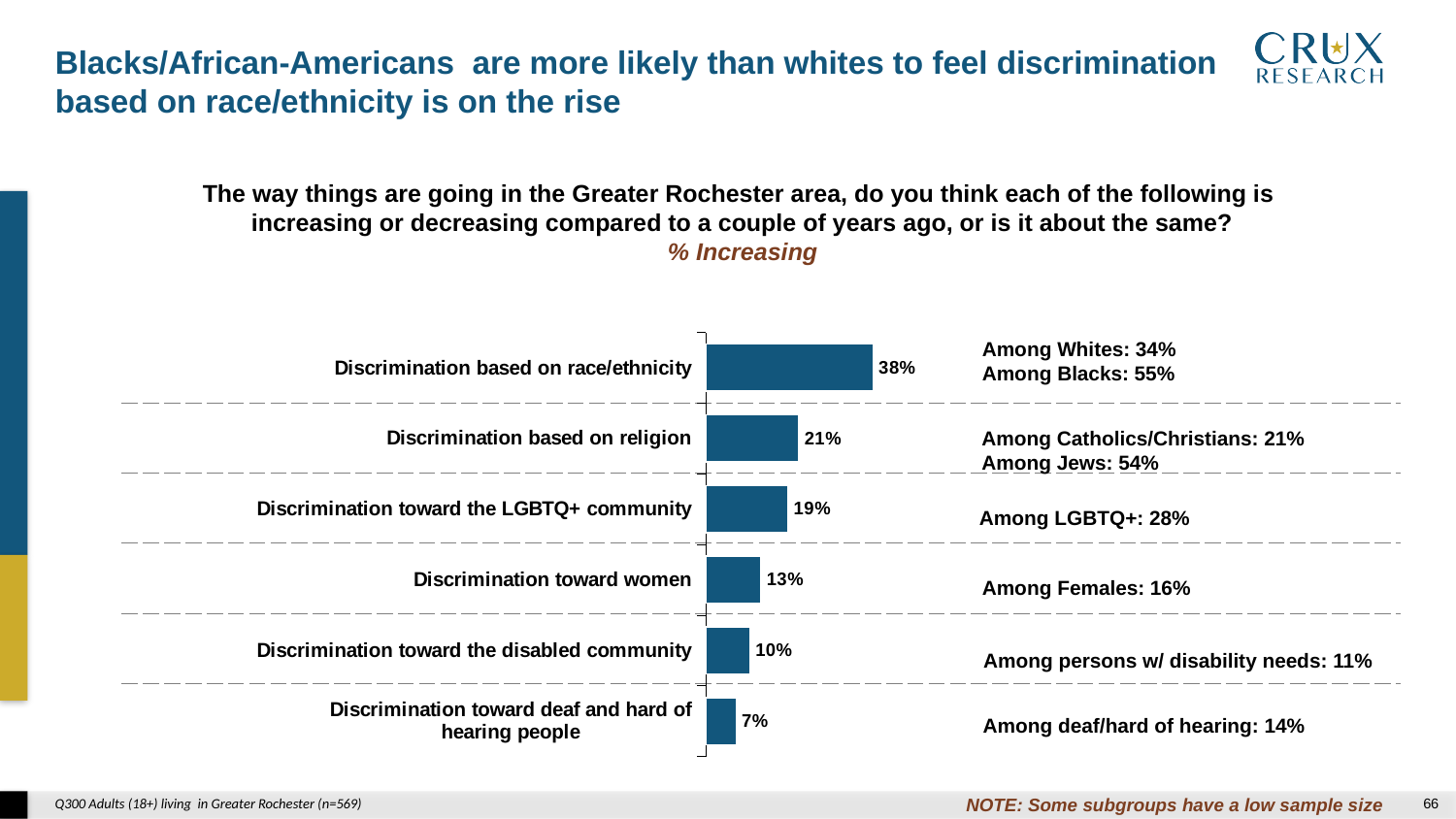
What kind of chart is shown on the slide? Bar chart What percentage say discrimination toward deaf and hard of hearing people is increasing? 7% What is the difference between the % increasing for discrimination based on race/ethnicity and discrimination based on religion? 17% Do the values rise or fall going from the top bar to the bottom bar? Fall How many categories are shown in the chart? 6 What is the subtitle shown in italics above the chart? % Increasing Which category has the highest % increasing? Discrimination based on race/ethnicity Which is larger: the % increasing for discrimination based on religion or for discrimination toward women? Discrimination based on religion What is the difference between the % increasing for discrimination toward women and discrimination toward the disabled community? 3% Which category has the lowest % increasing? Discrimination toward deaf and hard of hearing people What percentage say discrimination based on race/ethnicity is increasing? 38% What percentage say discrimination toward the LGBTQ+ community is increasing? 19%